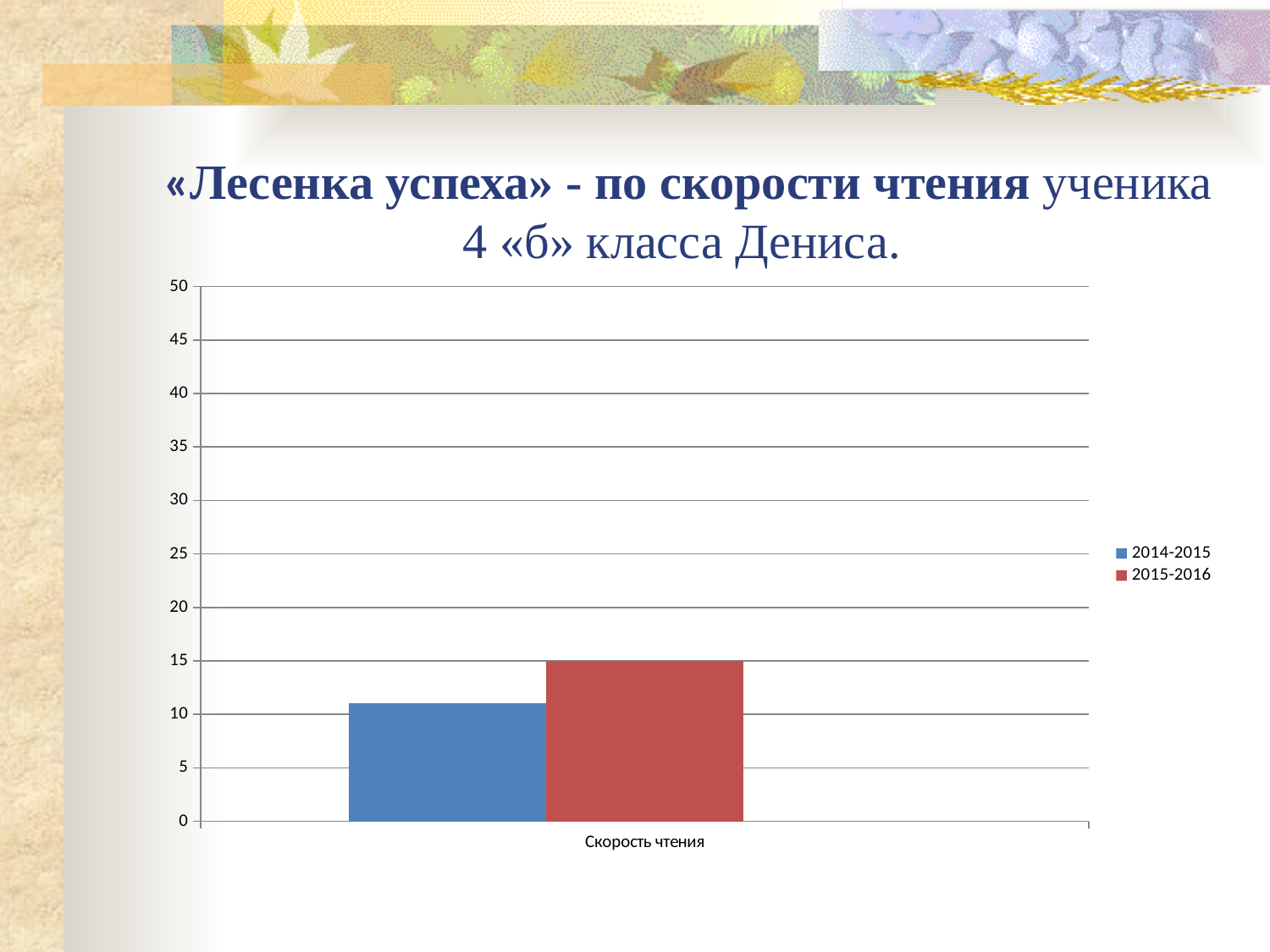
What is the value of the 2015-2016 bar for Скорость чтения? 15 Which series has the higher value: 2014-2015 or 2015-2016? 2015-2016 Which series has the lowest bar? 2014-2015 Is the value for 2014-2015 greater or less than 10? greater What kind of chart is shown on the slide? bar chart How many categories are shown on the x axis? 1 Which series has the highest bar? 2015-2016 Is the value for 2014-2015 greater or less than 15? less How many series does the legend list? 2 Did the reading speed rise or fall from 2014-2015 to 2015-2016? rise What is the label of the category on the x axis? Скорость чтения What colour is the bar for the 2015-2016 series? red